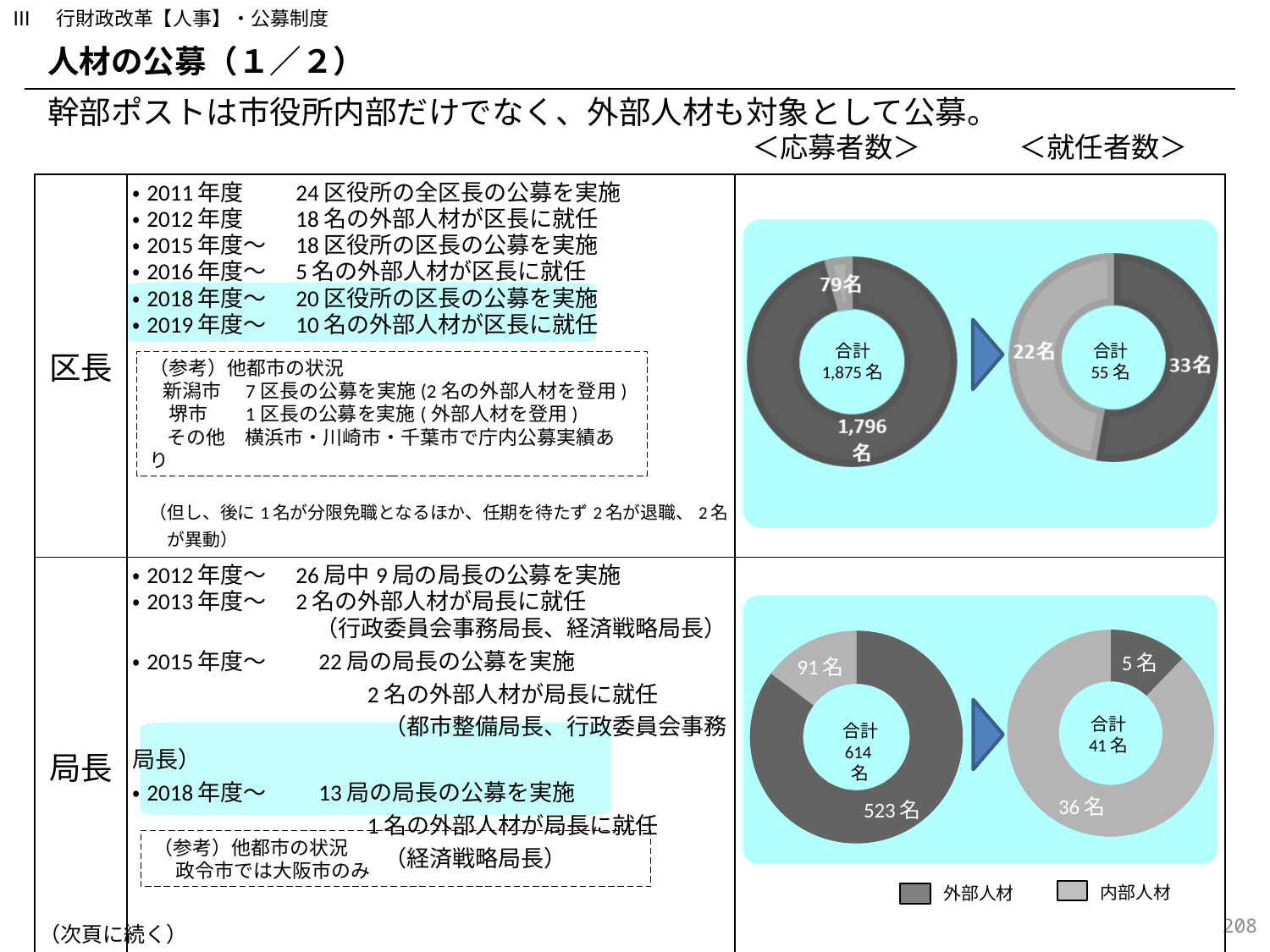
In the 局長 応募者数 donut chart, what is the difference between the two segments (523名 and 91名)? 432 名 In the 区長 応募者数 donut chart, what is the value of the larger segment? 1,796 名 What kind of chart is used to show 応募者数 and 就任者数 on this slide? Donut (pie) chart In the 区長 就任者数 donut chart, which segment is larger, 22名 or 33名? 33名 What are the two legend entries shown below the charts? 外部人材, 内部人材 In the 局長 就任者数 donut chart, what is the value of the smaller segment? 5名 In the 区長 応募者数 donut chart, what is the value of the smaller segment? 79名 In the 区長 応募者数 donut chart, what is the total (合計) shown in the centre? 1,875 名 How many segments does each donut chart on the slide have? 2 In the 局長 就任者数 donut chart, what is the total (合計) shown in the centre? 41 名 In the 局長 応募者数 donut chart, what is the total (合計) shown in the centre? 614 名 In the 区長 就任者数 donut chart, what is the total (合計) shown in the centre? 55 名